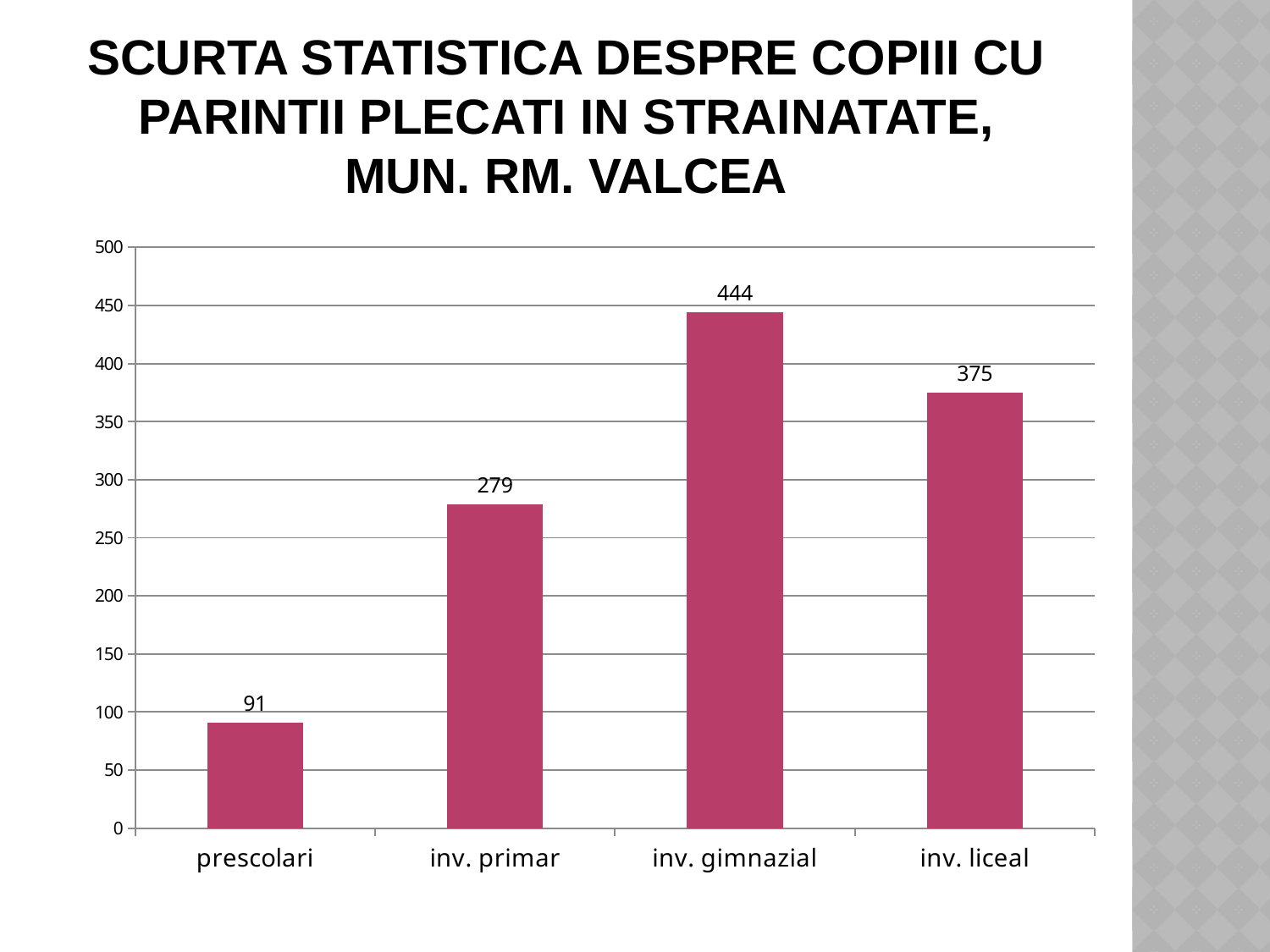
What is the value for inv. liceal? 375 What is the value for prescolari? 91 What is the value for inv. gimnazial? 444 What kind of chart is shown on the slide? bar chart How many categories are shown on the x axis? 4 What is the difference between the values for inv. gimnazial and inv. liceal? 69 Which category has the highest value? inv. gimnazial What is the value for inv. primar? 279 Which is larger, the value for inv. primar or the value for inv. liceal? inv. liceal Is the value for inv. primar greater or less than 300? less Which category has the lowest value? prescolari What is the difference between the values for inv. primar and prescolari? 188